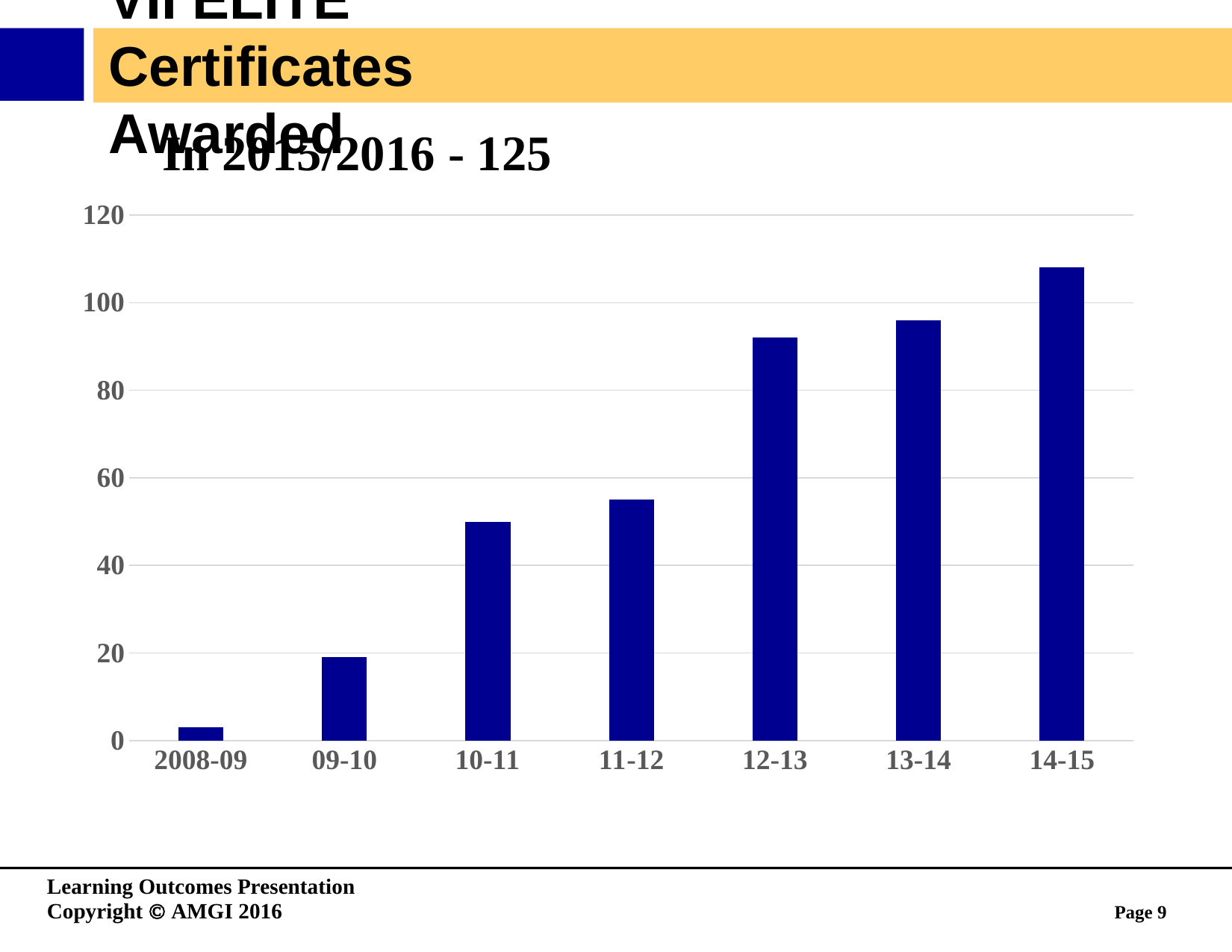
What is the title printed above the chart? In 2015/2016 - 125 Is the value for 13-14 greater or less than 100? less Which is larger, the value for 10-11 or the value for 12-13? 12-13 How many categories (years) are shown on the x axis of the chart? 7 Do the values generally rise or fall from 2008-09 to 14-15? rise Is the value for 12-13 greater or less than 80? greater Which year has the lowest bar in the chart? 2008-09 Which year has the highest bar in the chart? 14-15 What kind of chart is shown on the slide? bar chart Is the value for 2008-09 greater or less than 20? less